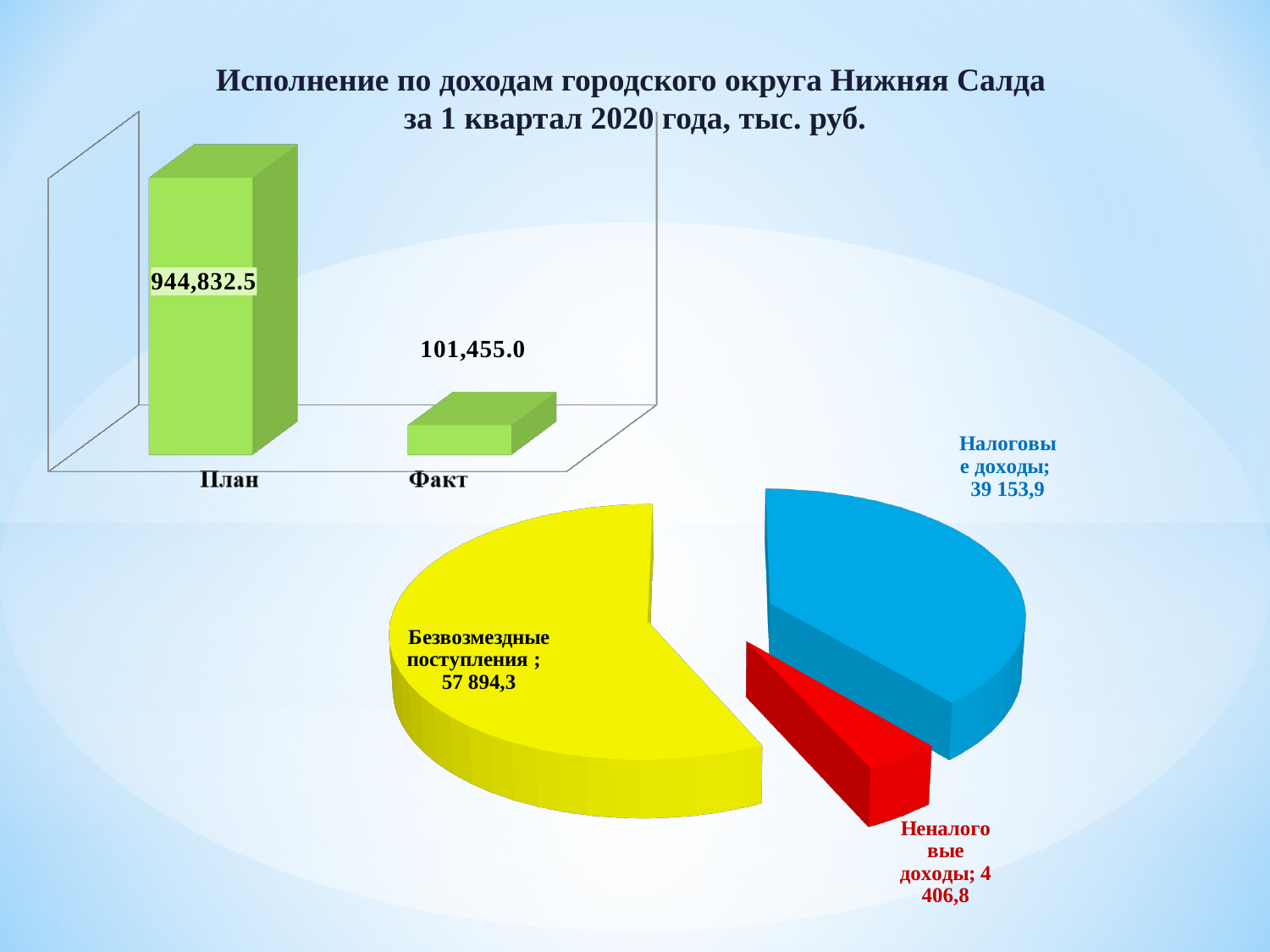
On the bar chart at the top left, how many categories are shown? 2 On the bar chart at the top left, what is the value for Факт? 101,455.0 On the pie chart, what is the value for Безвозмездные поступления? 57 894,3 What kind of chart is the one at the top left of the slide? Bar chart On the bar chart at the top left, which category has the higher value, План or Факт? План On the pie chart, what is the value for Налоговые доходы? 39 153,9 On the bar chart at the top left, what is the value for План? 944,832.5 On the pie chart, what is the difference between Безвозмездные поступления and Налоговые доходы? 18 740,4 On the pie chart, what is the value for Неналоговые доходы? 4 406,8 On the pie chart, which slice is the smallest? Неналоговые доходы On the pie chart, which slice is the largest? Безвозмездные поступления On the bar chart at the top left, what is the difference between План and Факт? 843,377.5